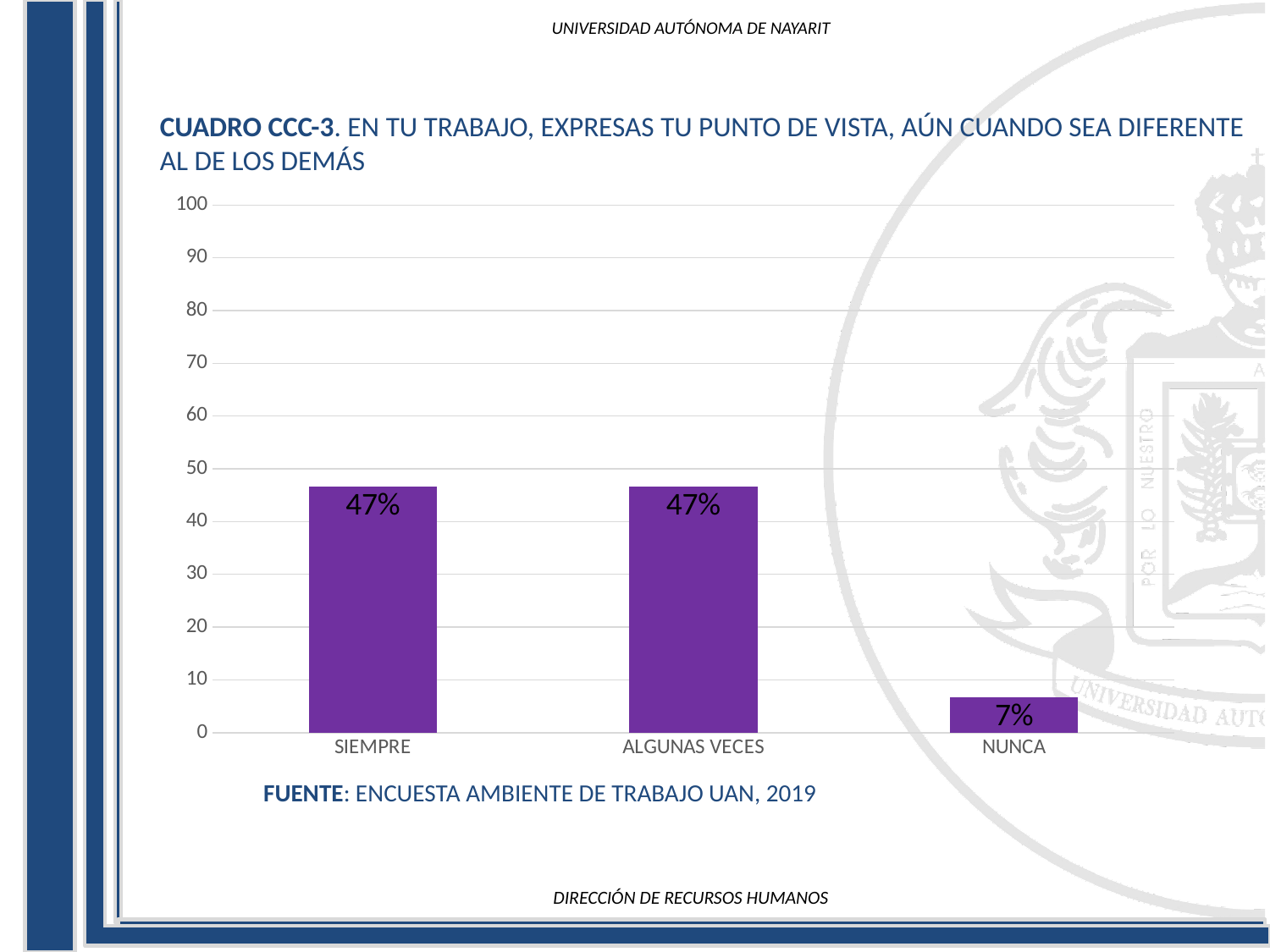
What is the source cited below the chart? ENCUESTA AMBIENTE DE TRABAJO UAN, 2019 What is the difference between the values for SIEMPRE and NUNCA? 40% What colour are the bars in the chart? purple Which category has the lowest value? NUNCA What kind of chart is shown on the slide? bar chart What is the value for ALGUNAS VECES? 47% Is the value for SIEMPRE greater or less than 40? greater What is the value for NUNCA? 7% What is the value for SIEMPRE? 47% Is the value for NUNCA greater or less than 10? less How many categories are shown on the x axis? 3 Which is larger, the value for ALGUNAS VECES or the value for NUNCA? ALGUNAS VECES